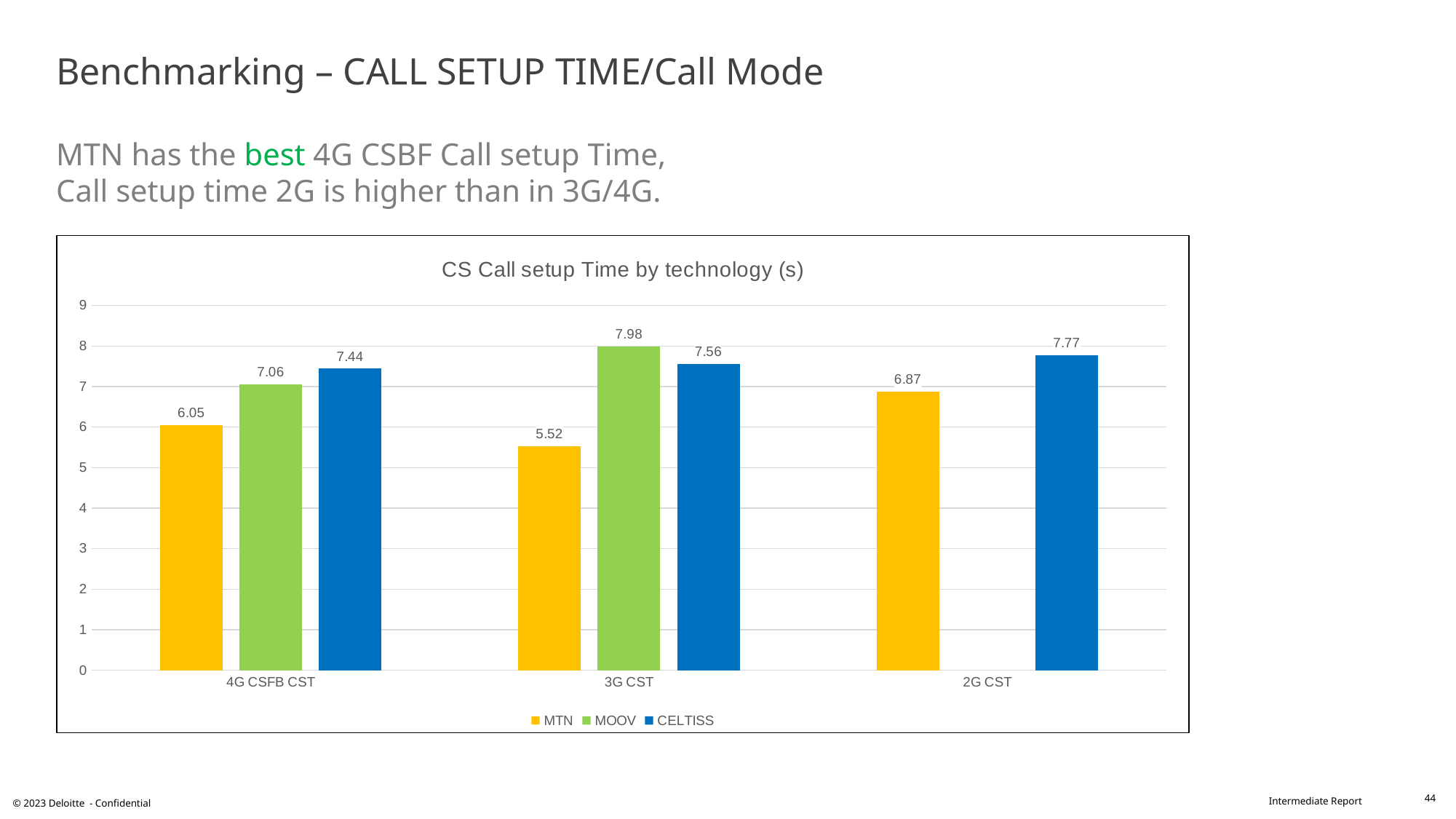
What is the title of the chart? CS Call setup Time by technology (s) Which operator has the highest value for 3G CST? MOOV What is the MTN value for 4G CSFB CST? 6.05 Which operator has no bar shown for 2G CST? MOOV How many categories are shown on the x axis? 3 What is the CELTISS value for 2G CST? 7.77 How many series does the legend list? 3 What kind of chart is shown? Bar chart What is the difference between the CELTISS and MTN values for 4G CSFB CST? 1.39 What is the MOOV value for 3G CST? 7.98 Which operator has the lowest value for 4G CSFB CST? MTN Which is larger, the MTN value for 2G CST or the MTN value for 3G CST? 2G CST